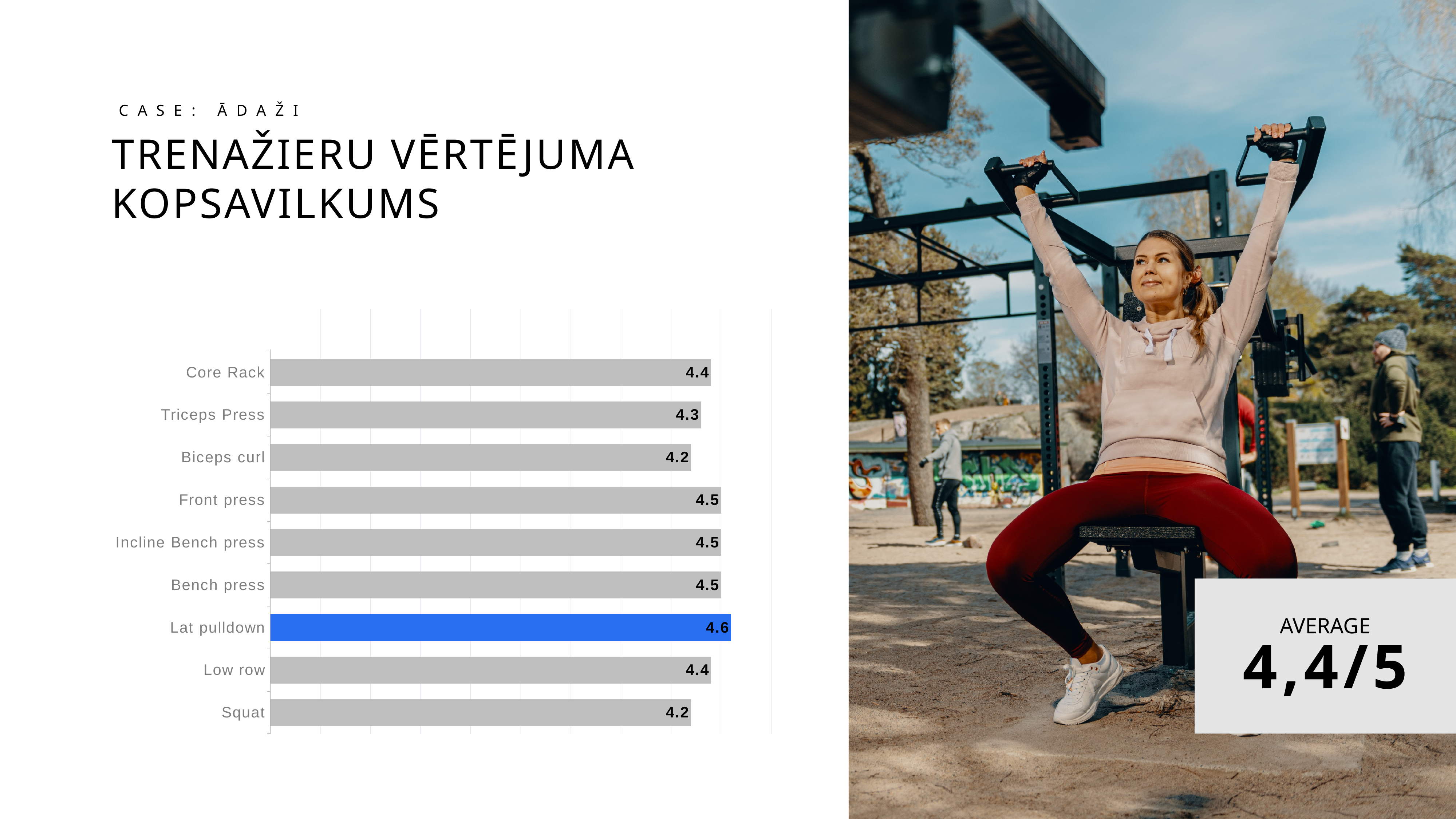
What is the value for Triceps Press? 4.3 What is the value for Squat? 4.2 Which is larger, the value for Core Rack or the value for Triceps Press? Core Rack What is the lowest value shown in the chart? 4.2 What is the difference between the values for Front press and Biceps curl? 0.3 What is the value for Lat pulldown? 4.6 What is the value for Core Rack? 4.4 What is the difference between the values for Lat pulldown and Squat? 0.4 How many categories are shown in the chart? 9 Which category has the highest value? Lat pulldown What kind of chart is shown on the slide? bar chart Which category's bar is highlighted in blue? Lat pulldown